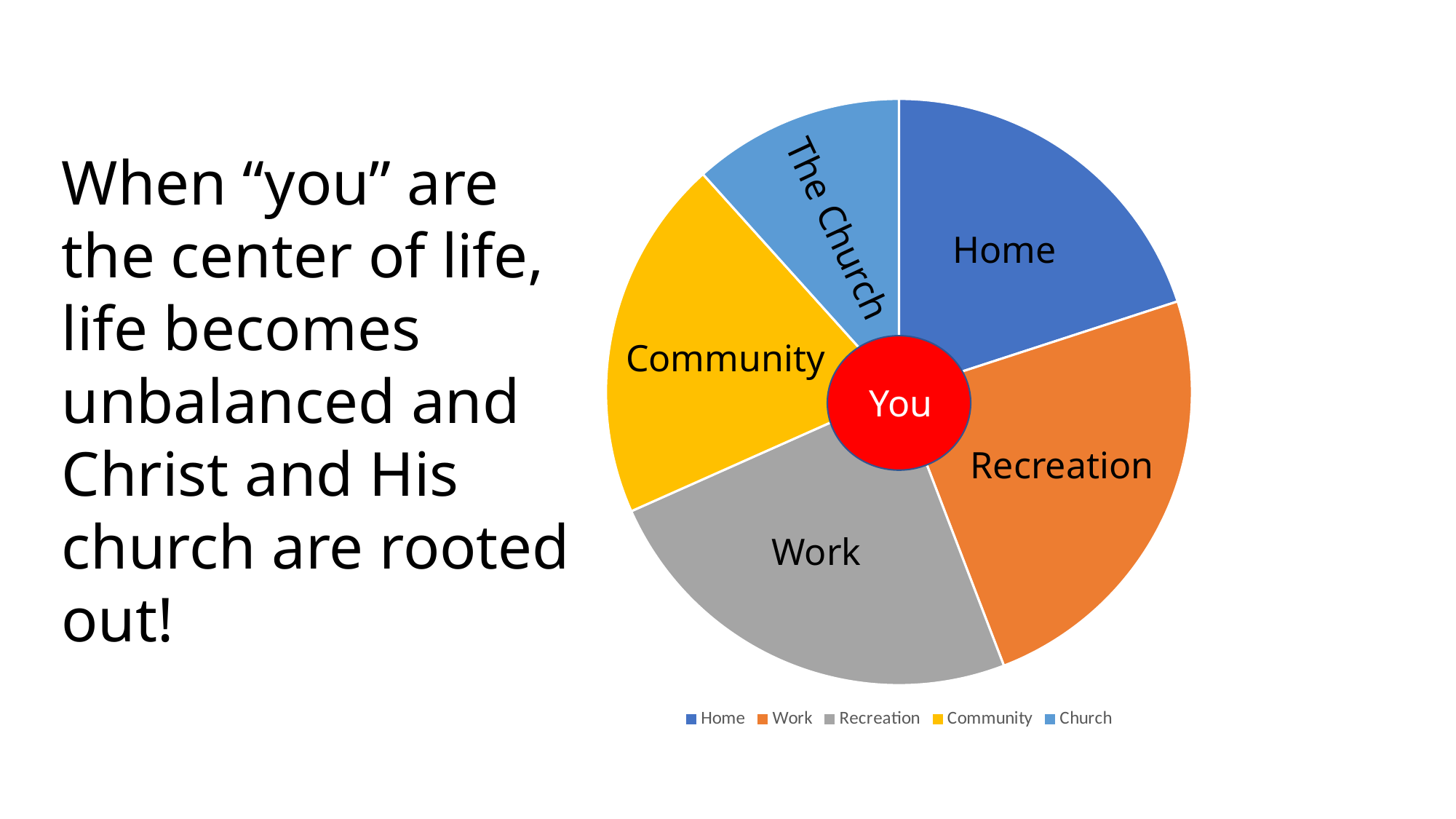
What kind of chart is shown on the slide? pie chart Which slice is larger, Work or The Church? Work Which slice is larger, Home or The Church? Home What colour is the Home slice of the pie chart? blue What word is written in the red circle at the center of the pie chart? You Which slice of the pie chart is the smallest? The Church How many slices does the pie chart have? 5 Which slice is larger, Community or The Church? Community How many entries does the legend of the pie chart list? 5